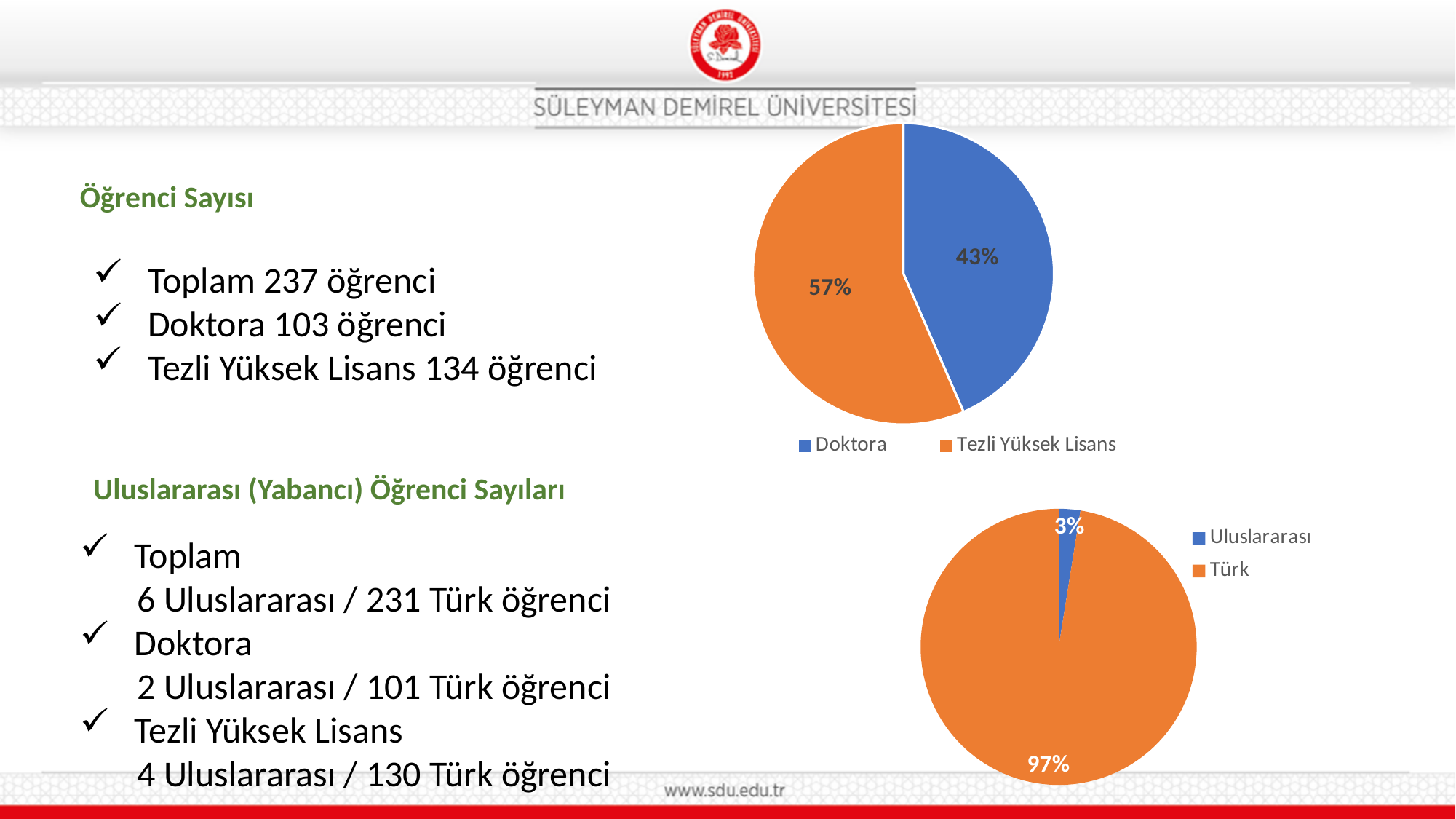
In the top pie chart, which slice is the largest? Tezli Yüksek Lisans In the top pie chart, how many slices are there? 2 In the top pie chart, what share is labelled for Tezli Yüksek Lisans? 57% In the bottom pie chart, which slice is larger, Uluslararası or Türk? Türk In the bottom pie chart, how many entries does the legend list? 2 In the bottom pie chart, what share is labelled for Uluslararası? 3% In the top pie chart, what is the difference in percentage points between Tezli Yüksek Lisans and Doktora? 14 In the bottom pie chart, what share is labelled for Türk? 97% In the bottom pie chart, what colour is the Türk slice? Orange What kind of chart is the top chart on the slide? Pie chart In the top pie chart, which slice is the smallest? Doktora